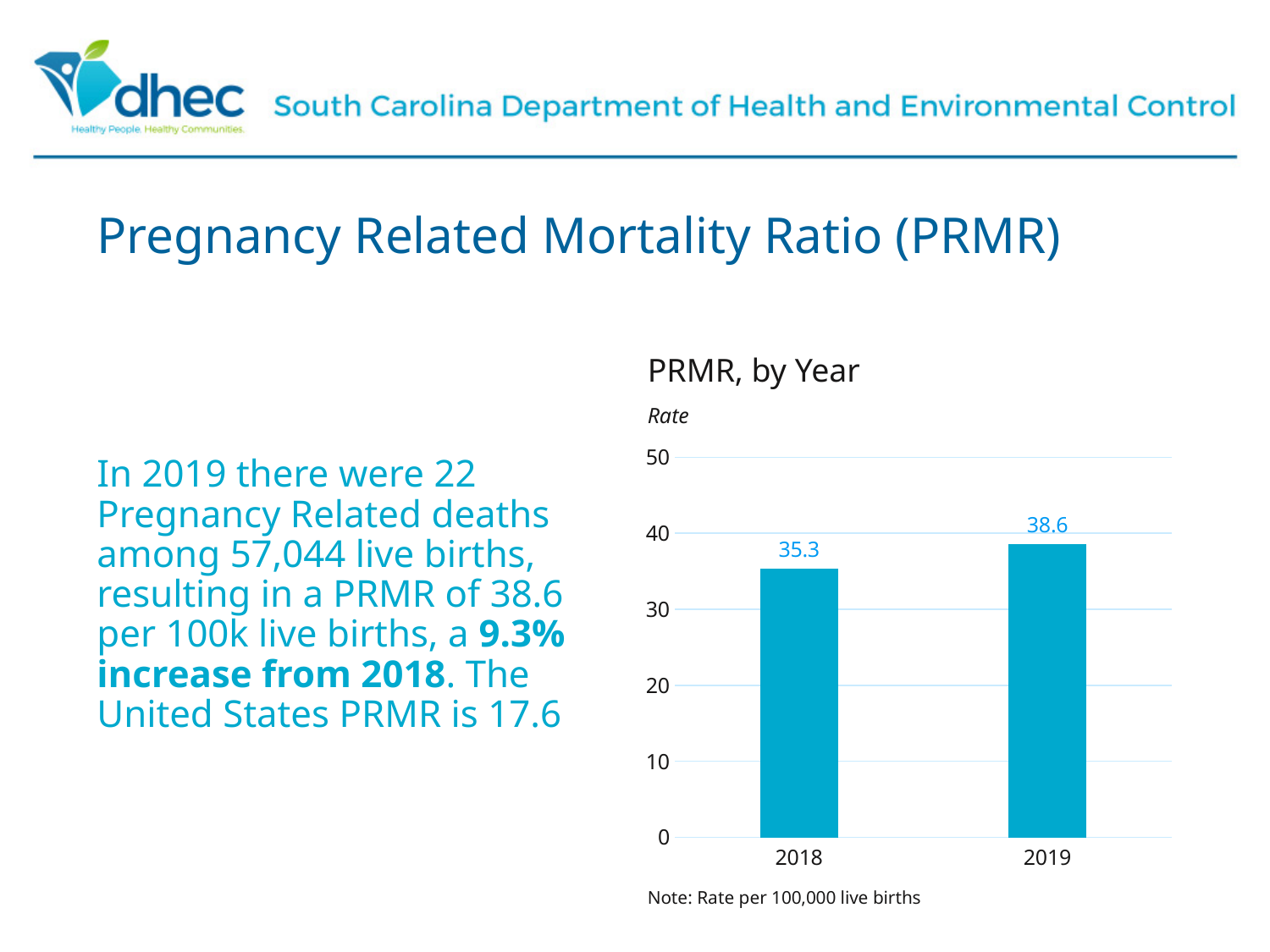
Which year has the lower PRMR? 2018 Is the PRMR for 2019 greater or less than 30? greater What is the maximum value shown on the chart's vertical axis? 50 What is the difference between the 2019 and 2018 PRMR values? 3.3 What is the PRMR value for 2019? 38.6 What is the PRMR value for 2018? 35.3 What is the title of the chart? PRMR, by Year Does the PRMR rise or fall from 2018 to 2019? rise How many years are shown in the chart? 2 What type of chart is shown on the slide? bar chart Which year has the higher PRMR? 2019 Is the PRMR for 2018 greater or less than 40? less